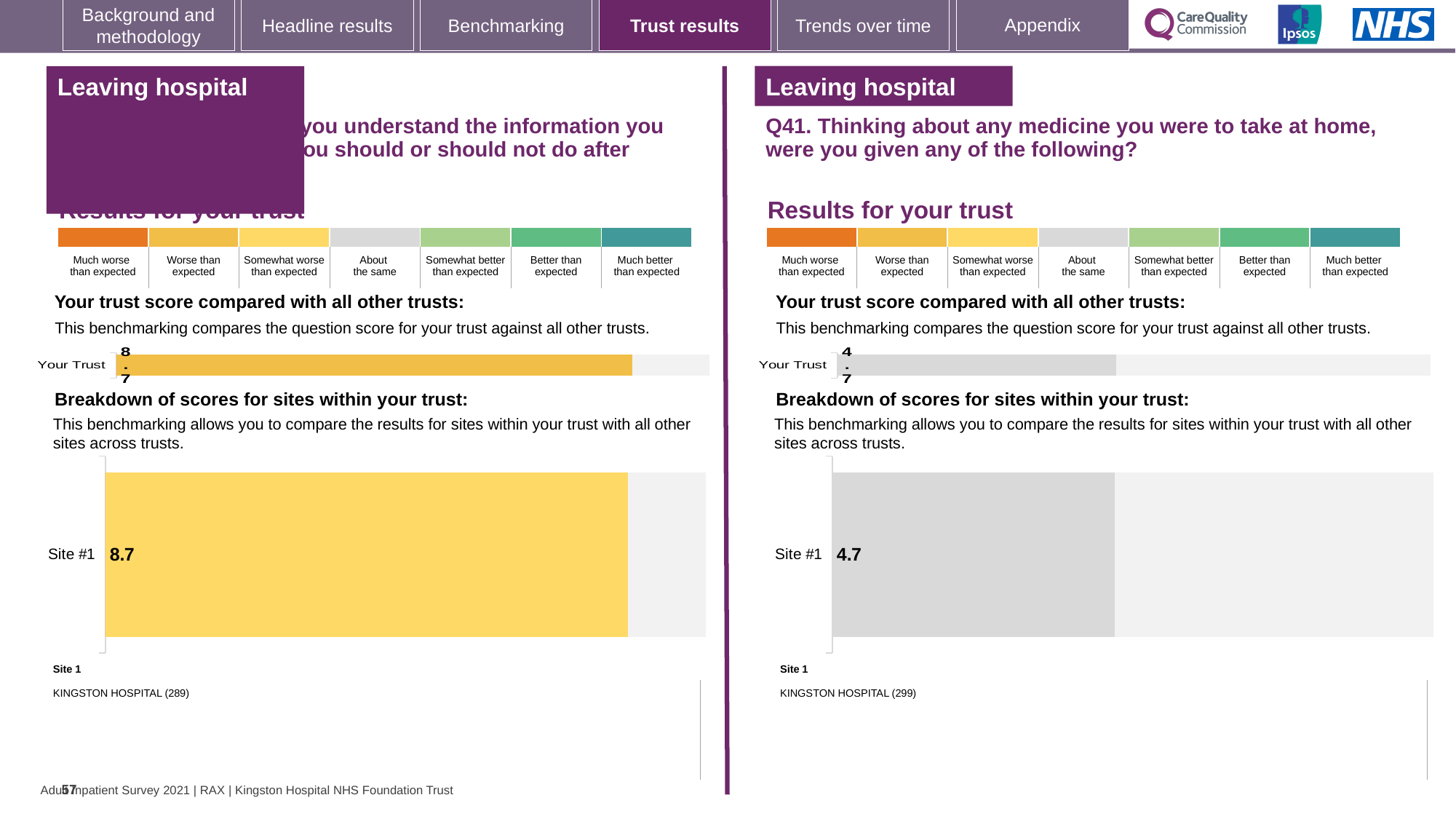
On the right half of the slide (Q41), what is the score shown for Your Trust? 4.7 What type of chart is used to show the Site #1 score on the right half of the slide (Q41)? Bar chart What is the difference between the Site #1 score on the left half of the slide and the Site #1 score on the right half (Q41)? 4.0 How many sites are shown in the right-hand 'Breakdown of scores for sites within your trust' chart (Q41)? 1 On the left half of the slide, what is the score shown for Your Trust? 8.7 In the right-hand 'Breakdown of scores for sites within your trust' chart (Q41), what is the score for Site #1? 4.7 Which site name is listed under Site 1 on the left half of the slide? KINGSTON HOSPITAL (289) Which is larger: the Your Trust score on the left half of the slide or the Your Trust score on the right half (Q41)? Left half (8.7) Is the Site #1 score on the left half of the slide the same as the Your Trust score on the left half? Yes, both are 8.7 Which site name is listed under Site 1 on the right half of the slide (Q41)? KINGSTON HOSPITAL (299) How many sites are shown in the left-hand 'Breakdown of scores for sites within your trust' chart? 1 In the left-hand 'Breakdown of scores for sites within your trust' chart, what is the score for Site #1? 8.7